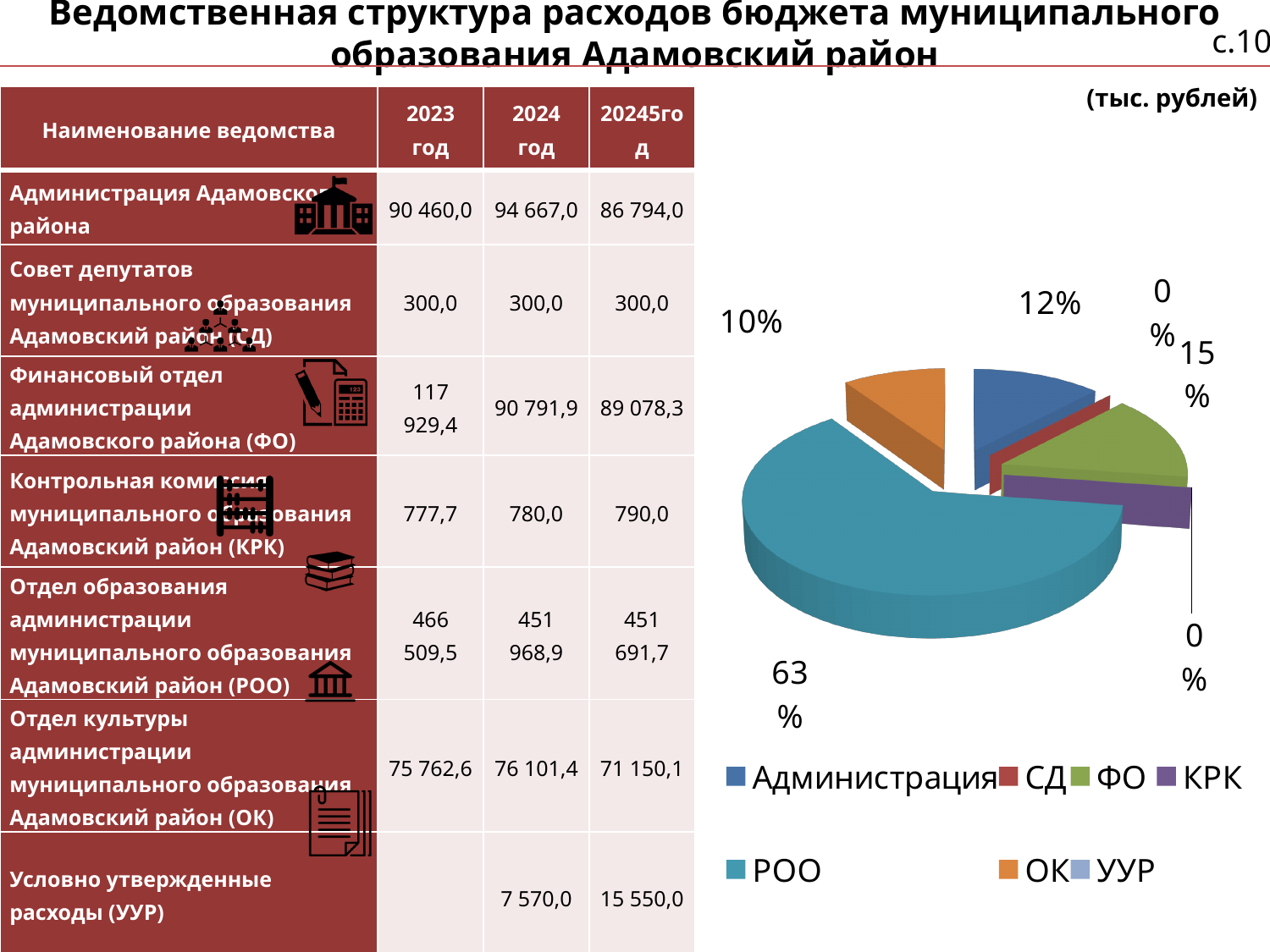
Which slice is larger, РОО or ОК? РОО By how many percentage points does the РОО share exceed the ФО share? 48 What share of the pie does ОК account for? 10% What colour is the РОО slice in the pie chart? teal What share of the pie does Администрация account for? 12% What share of the pie does РОО account for? 63% What kind of chart is shown on the slide? pie chart What unit is indicated above the pie chart? тыс. рублей Which slice is larger, ФО or Администрация? ФО How many entries does the legend of the pie chart list? 7 Which category has the largest slice of the pie? РОО